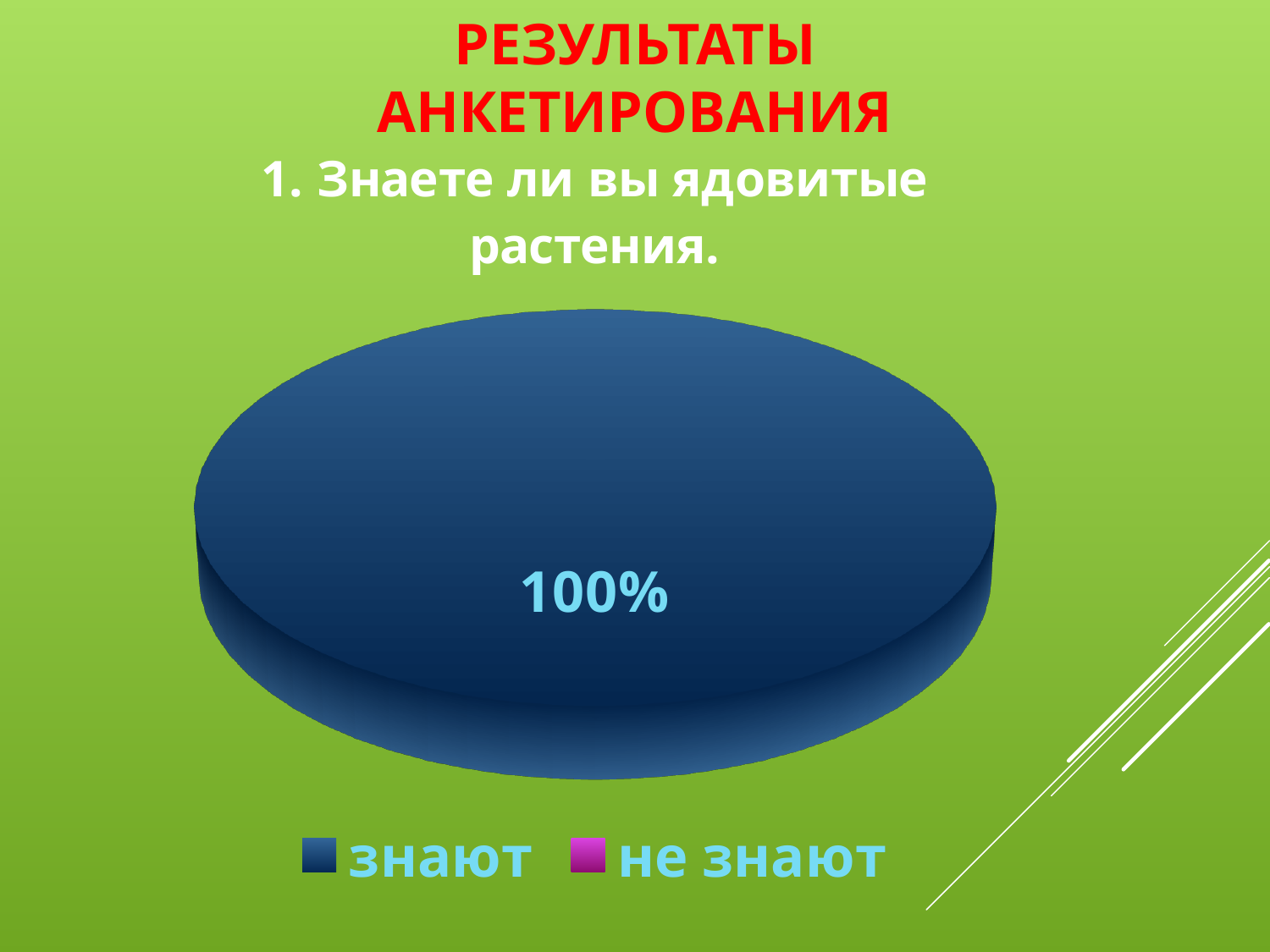
How many entries does the legend of the pie chart list? 2 What colour does the legend use for the "знают" category? dark blue What is the title of the chart on the slide? 1. Знаете ли вы ядовитые растения. What percentage is shown for the "знают" slice of the pie chart? 100% What is the only data label printed on the pie chart? 100% What share of the pie does the "знают" slice take up? 100% What kind of chart is shown on the slide? pie chart Which category has the largest share of the pie chart? знают Which of the two legend categories, "знают" or "не знают", has the larger share of the pie? знают